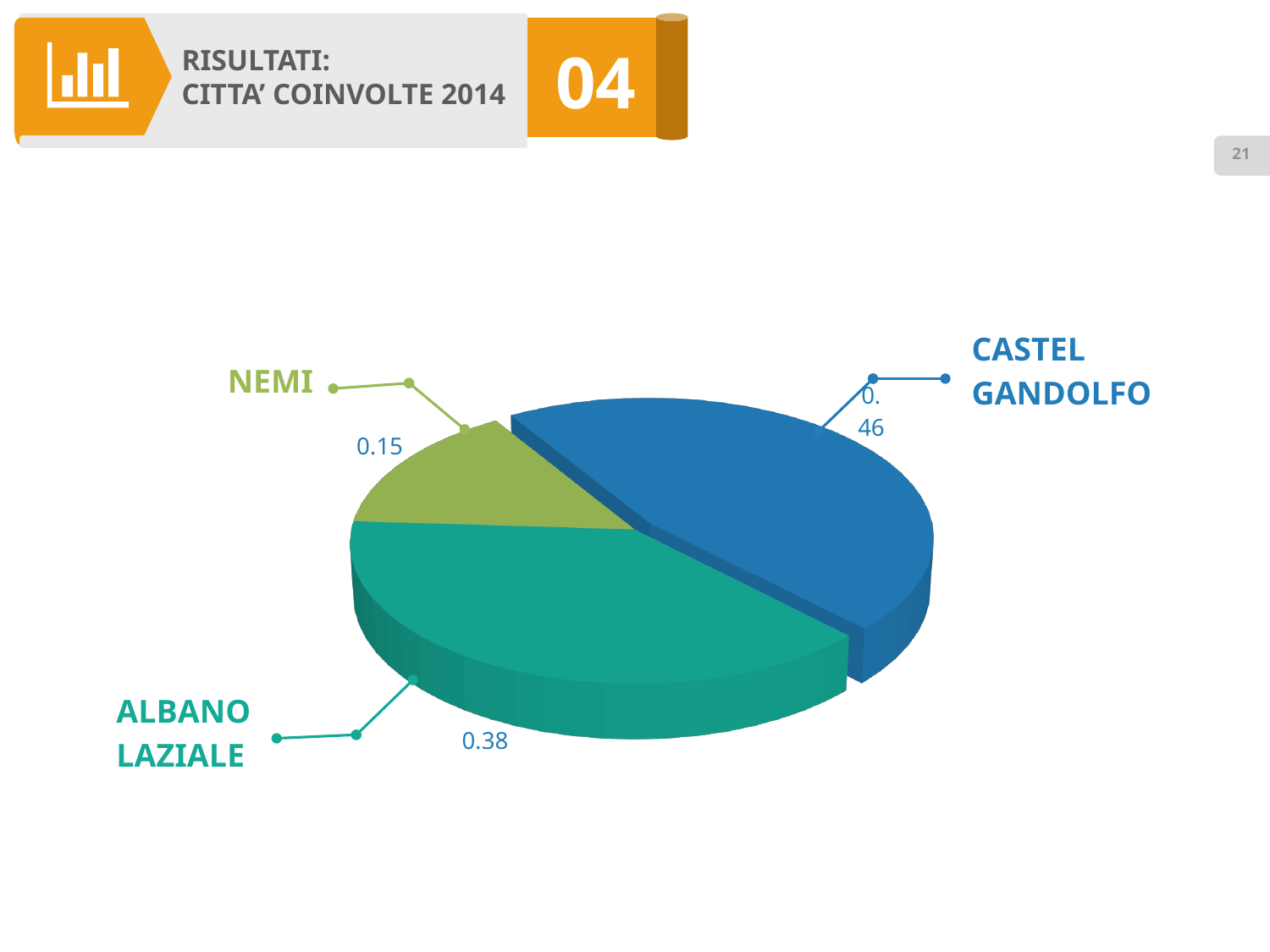
How many cities are shown in the pie chart? 3 Which city has the largest slice of the pie chart? Castel Gandolfo What value is shown for Nemi in the pie chart? 0.15 Which is larger, the value for Albano Laziale or the value for Nemi? Albano Laziale Which city has the smallest slice of the pie chart? Nemi What value is shown for Castel Gandolfo in the pie chart? 0.46 What is the difference between the values for Albano Laziale and Nemi? 0.23 What is the title shown in the header of the slide? RISULTATI: CITTA' COINVOLTE 2014 What value is shown for Albano Laziale in the pie chart? 0.38 What colour is the slice for Nemi in the pie chart? Green What kind of chart is shown on the slide? Pie chart What is the difference between the values for Castel Gandolfo and Albano Laziale? 0.08